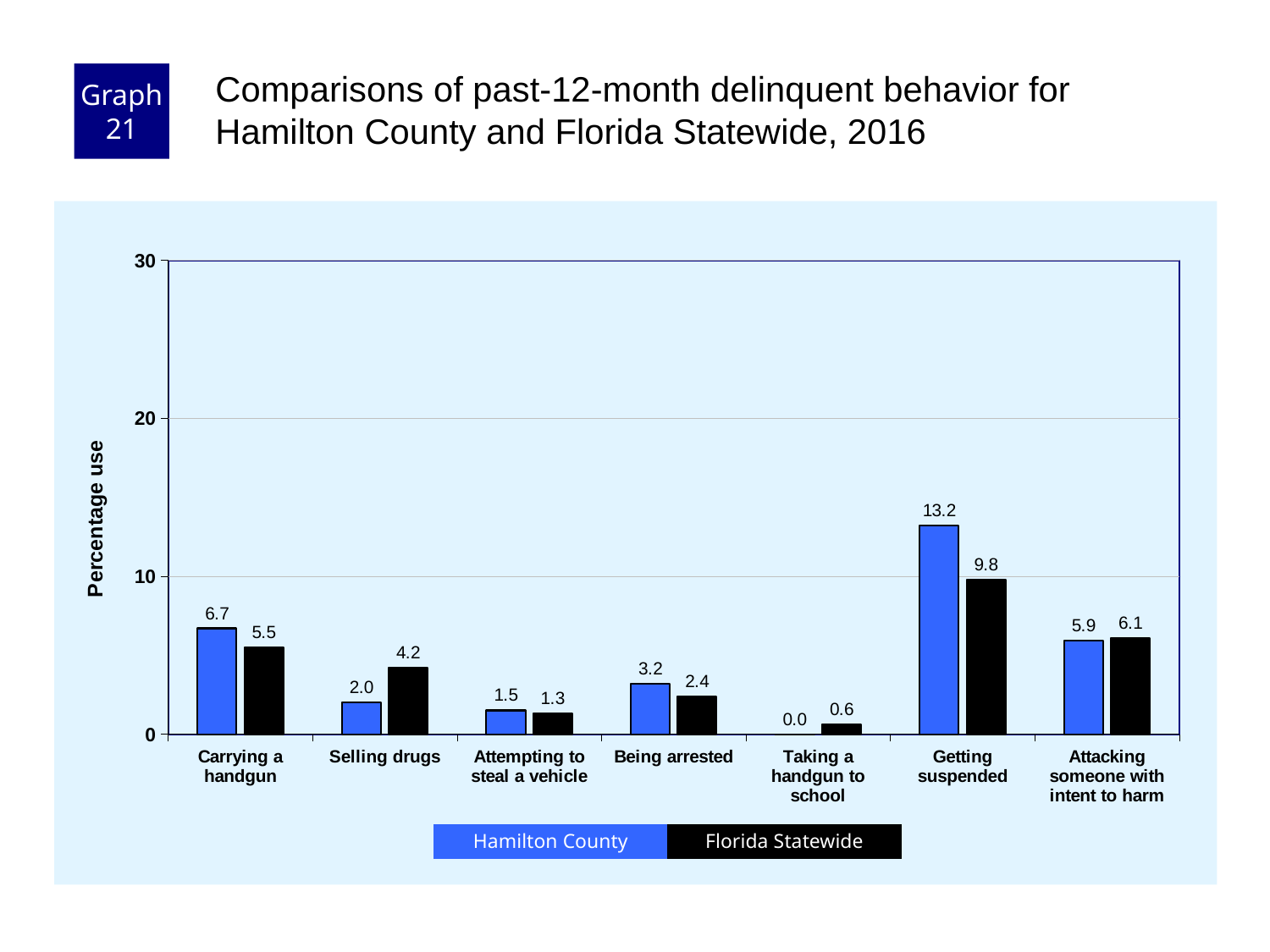
What is the difference between the Hamilton County and Florida Statewide values for Getting suspended? 3.4 Which category has the highest Hamilton County value? Getting suspended Which is larger for Attacking someone with intent to harm, Hamilton County or Florida Statewide? Florida Statewide What is the Florida Statewide value for Selling drugs? 4.2 Is the Hamilton County value for Getting suspended greater or less than 10? greater What is the Hamilton County value for Getting suspended? 13.2 What is the label of the y axis? Percentage use What kind of chart is shown on the slide? bar chart What is the Hamilton County value for Taking a handgun to school? 0.0 How many series does the legend list? 2 How many categories are shown on the x axis? 7 Which category has the lowest Florida Statewide value? Taking a handgun to school